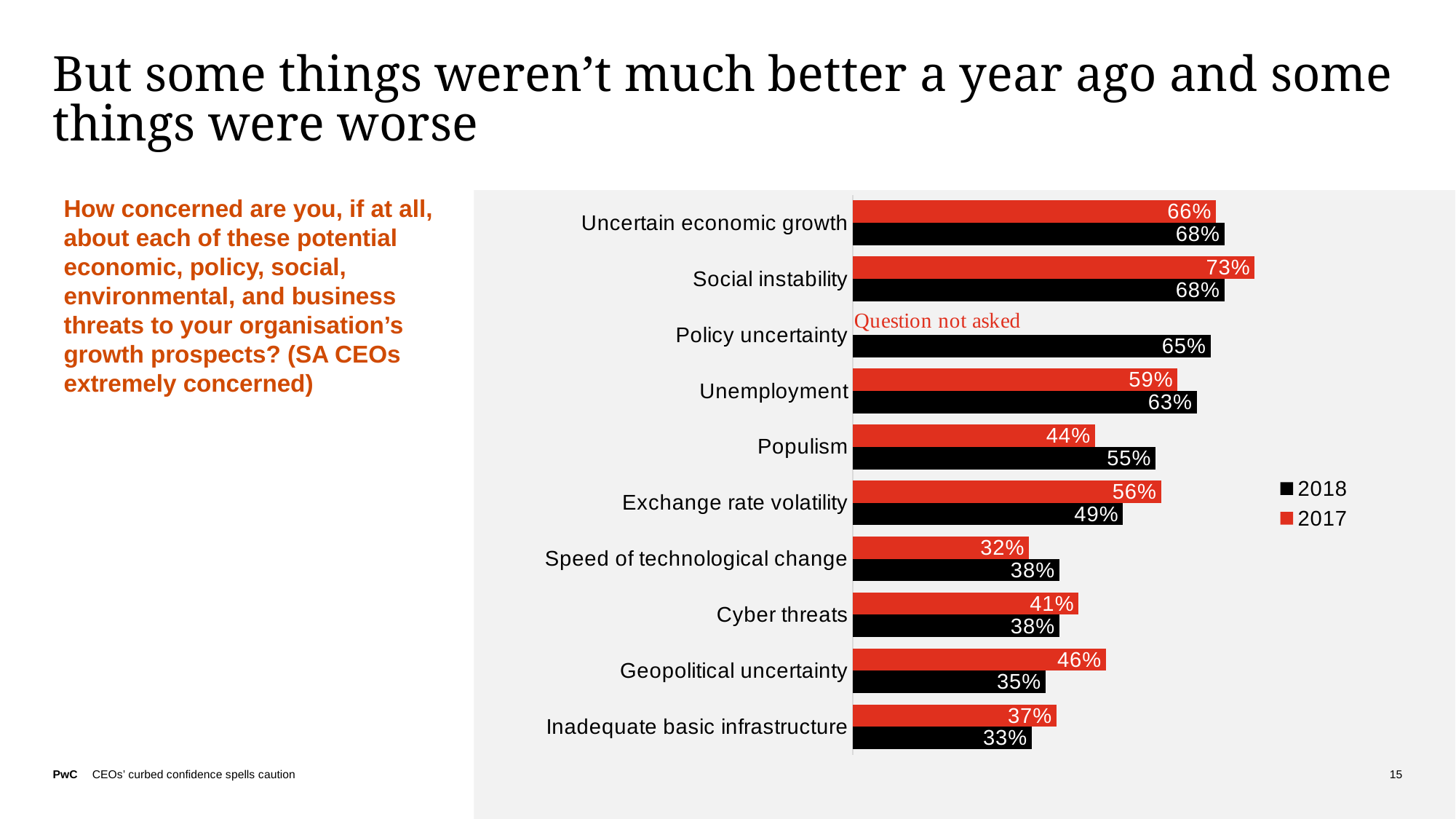
How many series does the legend list? 2 How many categories are shown on the chart? 10 What percentage of SA CEOs were extremely concerned about Social instability in 2017? 73% Which category has the lowest 2017 value? Speed of technological change Which category has the highest 2017 value? Social instability For Exchange rate volatility, which year has the larger value, 2017 or 2018? 2017 Which category has the lowest 2018 value? Inadequate basic infrastructure What note is shown in place of the 2017 bar for Policy uncertainty? Question not asked What is the difference between the 2017 and 2018 values for Geopolitical uncertainty? 11% What is the 2018 value for Policy uncertainty? 65% What is the 2018 value for Populism? 55% What kind of chart is shown on the slide? Bar chart